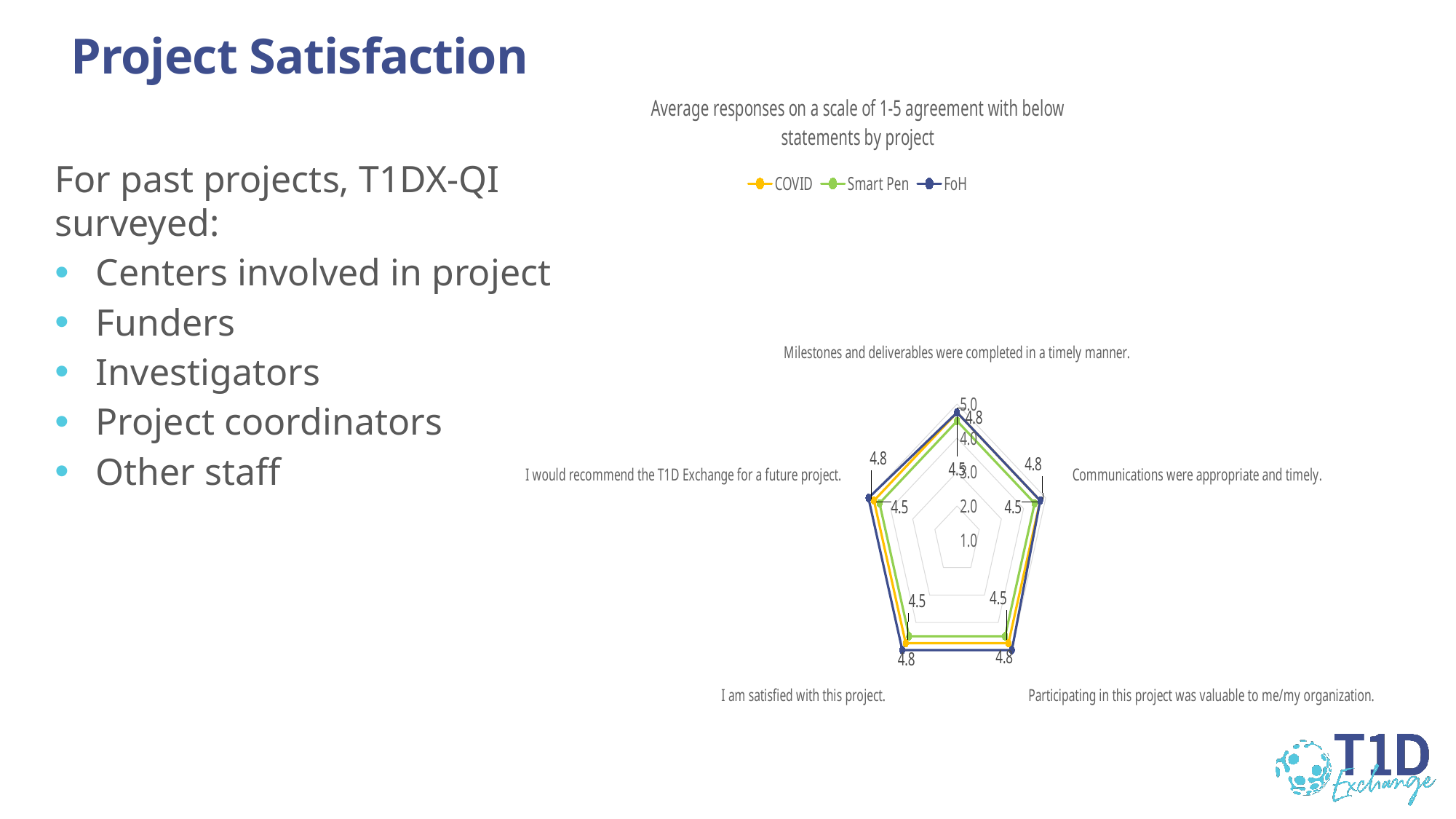
How many statements (axes) does the radar chart have? 5 Which series is plotted closest to the centre of the radar chart on 'Participating in this project was valuable to me/my organization.'? Smart Pen Is the value for Smart Pen on 'I am satisfied with this project.' greater or less than 4.0? greater What is the title of the chart? Average responses on a scale of 1-5 agreement with below statements by project What is the maximum value shown on the chart's scale? 5.0 What kind of chart is shown on the slide? Radar chart Which is larger on 'I would recommend the T1D Exchange for a future project.': FoH or Smart Pen? FoH How many series does the chart legend list? 3 Which series are listed in the chart legend? COVID, Smart Pen, FoH Is the value for COVID on 'Communications were appropriate and timely.' greater or less than 3.0? greater Is the value for FoH on 'Milestones and deliverables were completed in a timely manner.' greater or less than 4.0? greater